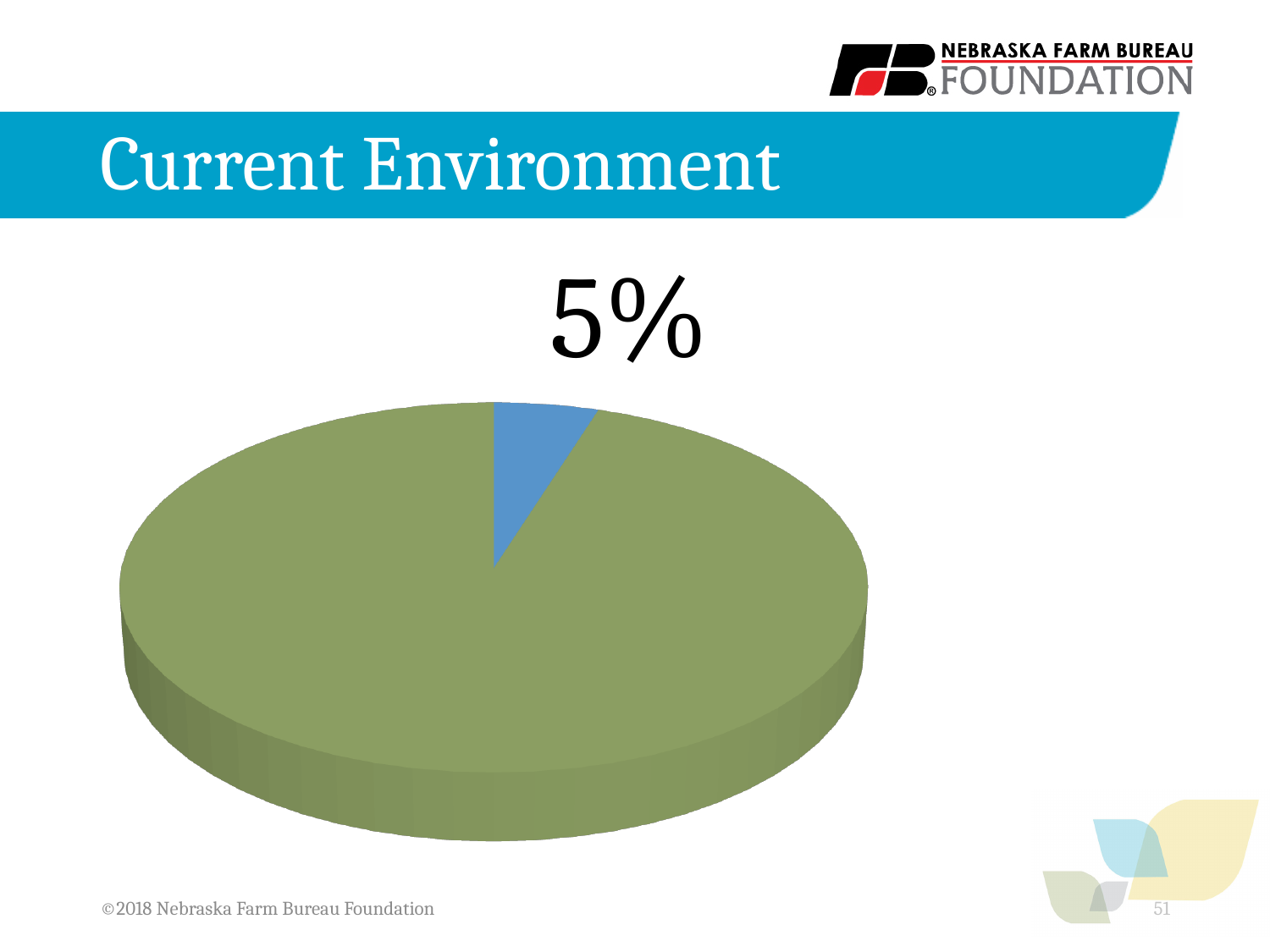
Is the blue slice's share of the pie greater or less than 10%? less What kind of chart is shown on the slide? pie chart What percentage is printed as the data label on the pie chart? 5% What is the title shown on the slide above the pie chart? Current Environment Which slice of the pie is larger, the blue one or the green one? green What colour is the slice labelled 5%? blue Which slice of the pie is the smallest? the blue slice What share of the pie does the blue slice represent? 5% How many slices does the pie chart have? 2 Is the green slice's share of the pie greater or less than 50%? greater